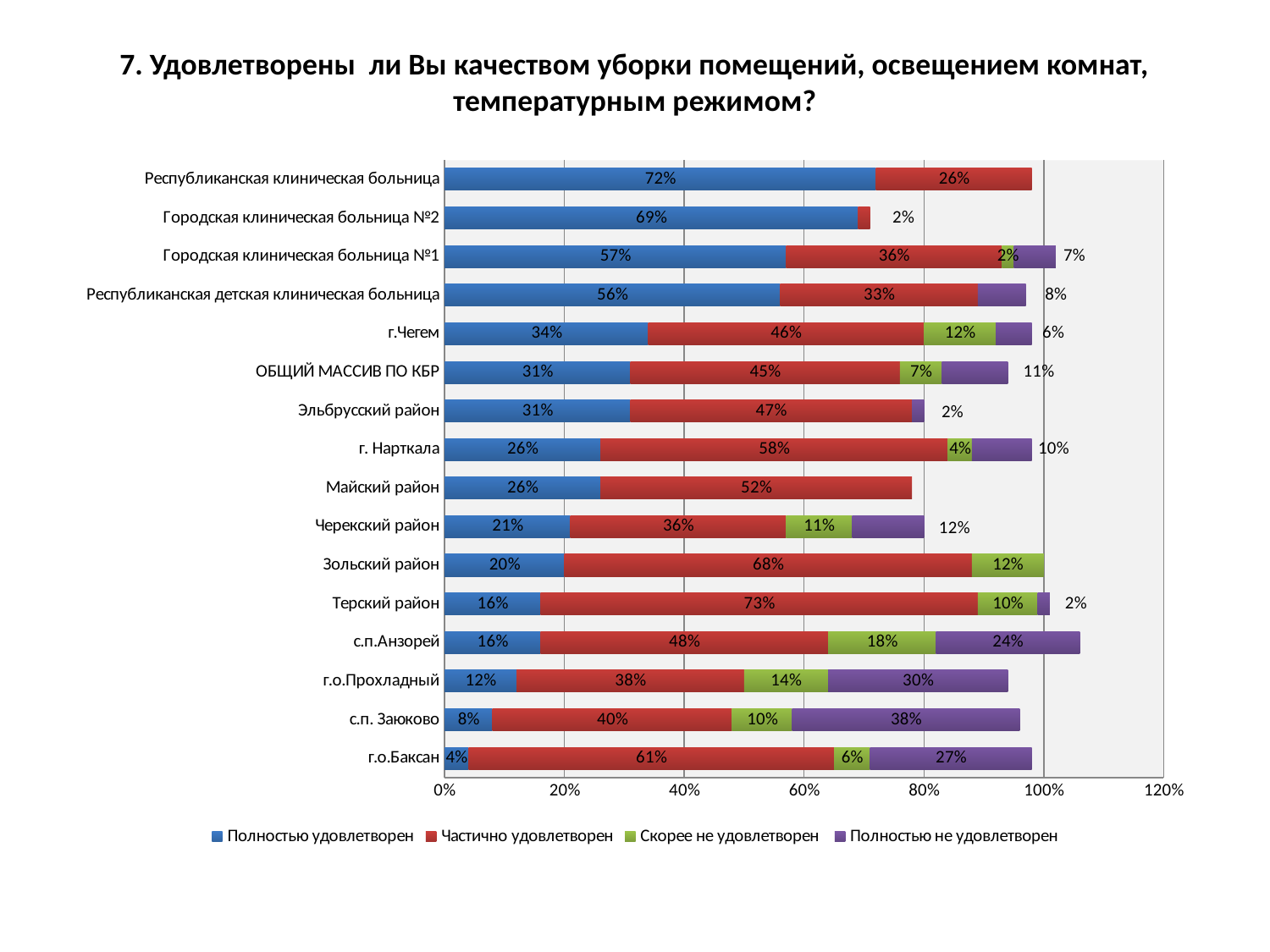
What is the value of "Частично удовлетворен" for Терский район? 73% What is the total of the labelled segments for г.Чегем? 98% Which category has the lowest value for "Полностью удовлетворен"? г.о.Баксан How many categories are shown on the vertical axis of the chart? 16 What is the value of "Полностью удовлетворен" for Республиканская клиническая больница? 72% What kind of chart is shown on the slide? Stacked bar chart What is the value of "Полностью не удовлетворен" for с.п. Заюково? 38% Which series is shown in blue according to the legend? Полностью удовлетворен Which has a larger "Полностью не удовлетворен" value: г.о.Прохладный or с.п.Анзорей? г.о.Прохладный How many series does the legend list? 4 Which category has the highest value for "Полностью удовлетворен"? Республиканская клиническая больница What is the difference between the "Частично удовлетворен" values for Зольский район and Черекский район? 32 percentage points